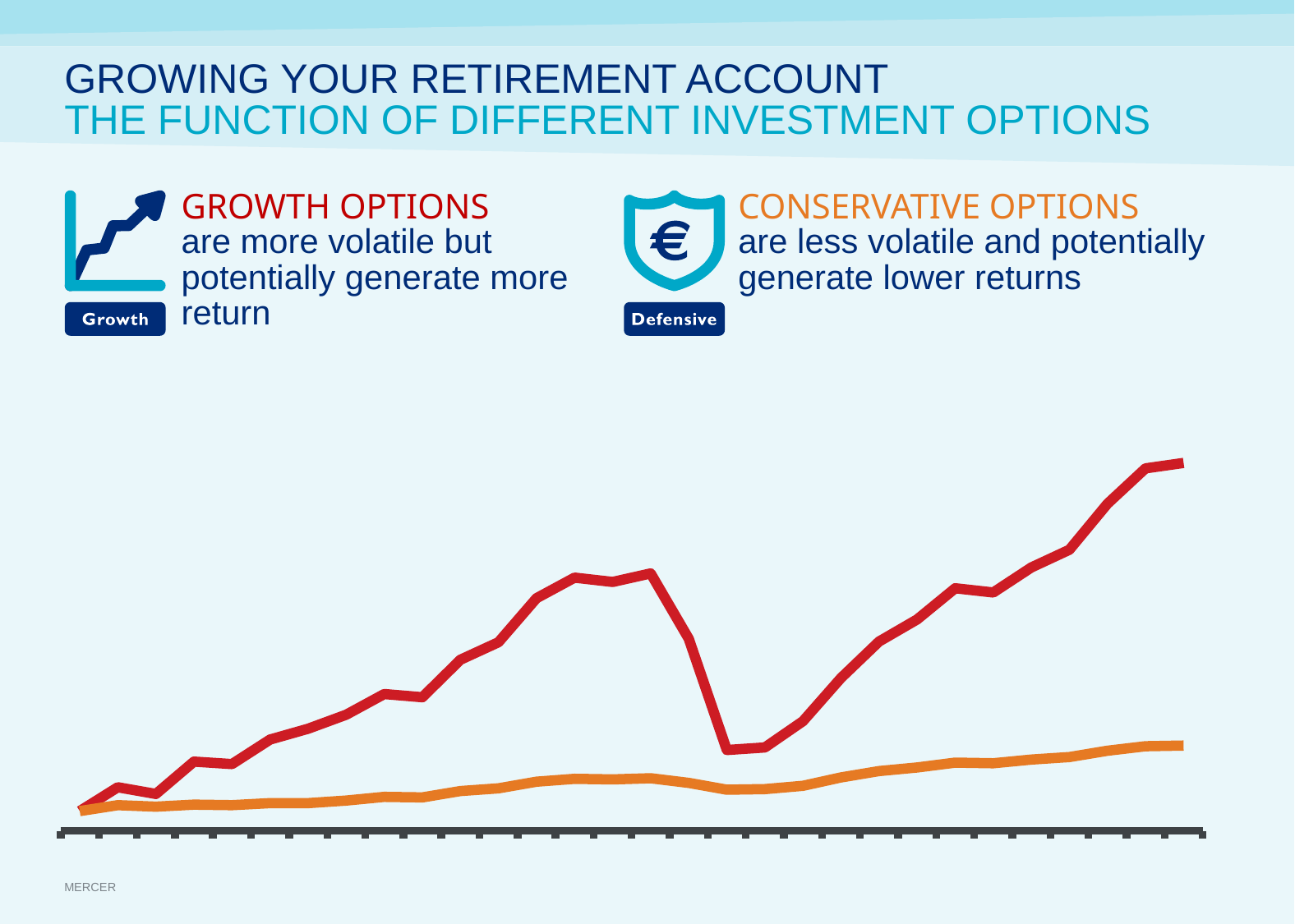
Do the red and orange lines start at roughly the same level at the left of the chart? yes What kind of chart is shown at the bottom of the slide? line chart Does the orange line on the chart generally rise or fall from left to right? rise Which investment option does the red line on the chart represent? Growth options Does the red line on the chart generally rise or fall from left to right? rise Does the red line on the chart show a sharp drop partway along the x axis? yes Which investment option does the orange line on the chart represent? Conservative options How many lines are plotted on the chart? 2 Which line on the chart shows the larger swings up and down, the red line or the orange line? the red line At the right-hand end of the chart, which line is higher, the red line or the orange line? the red line